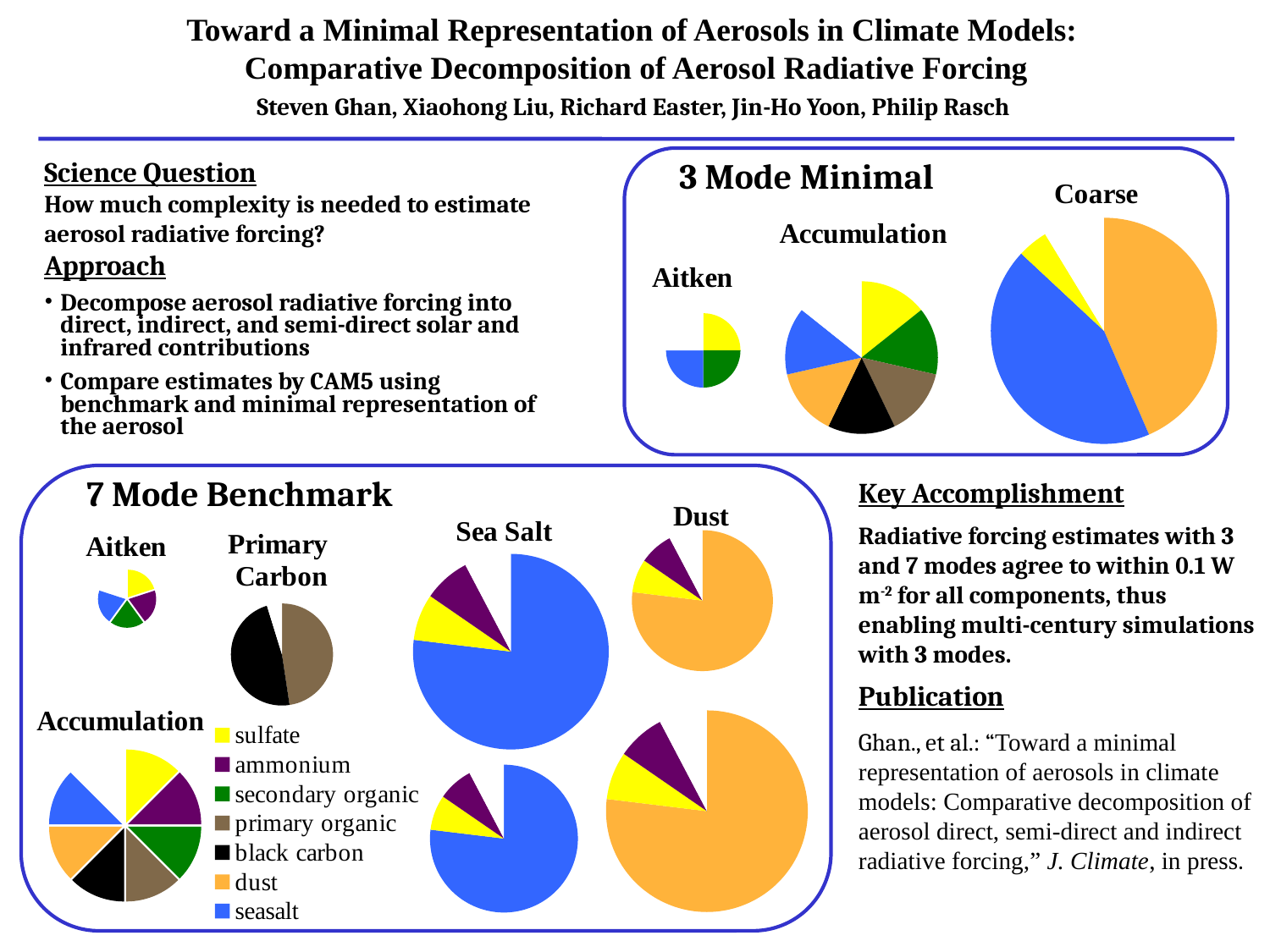
What kind of chart is used to show the aerosol mode compositions on this slide? pie chart How many entries does the legend in the 7 Mode Benchmark box list? 7 According to the legend, what colour represents black carbon? black In the 7 Mode Benchmark box, which component has the largest slice of the Dust pie? dust In the 7 Mode Benchmark box, which component has the largest slice of the Sea Salt pie? seasalt In the 3 Mode Minimal box, which component has the smallest slice of the Coarse pie? sulfate In the 7 Mode Benchmark Sea Salt pie, which slice is larger: seasalt or sulfate? seasalt How many pie charts are shown in the 3 Mode Minimal box? 3